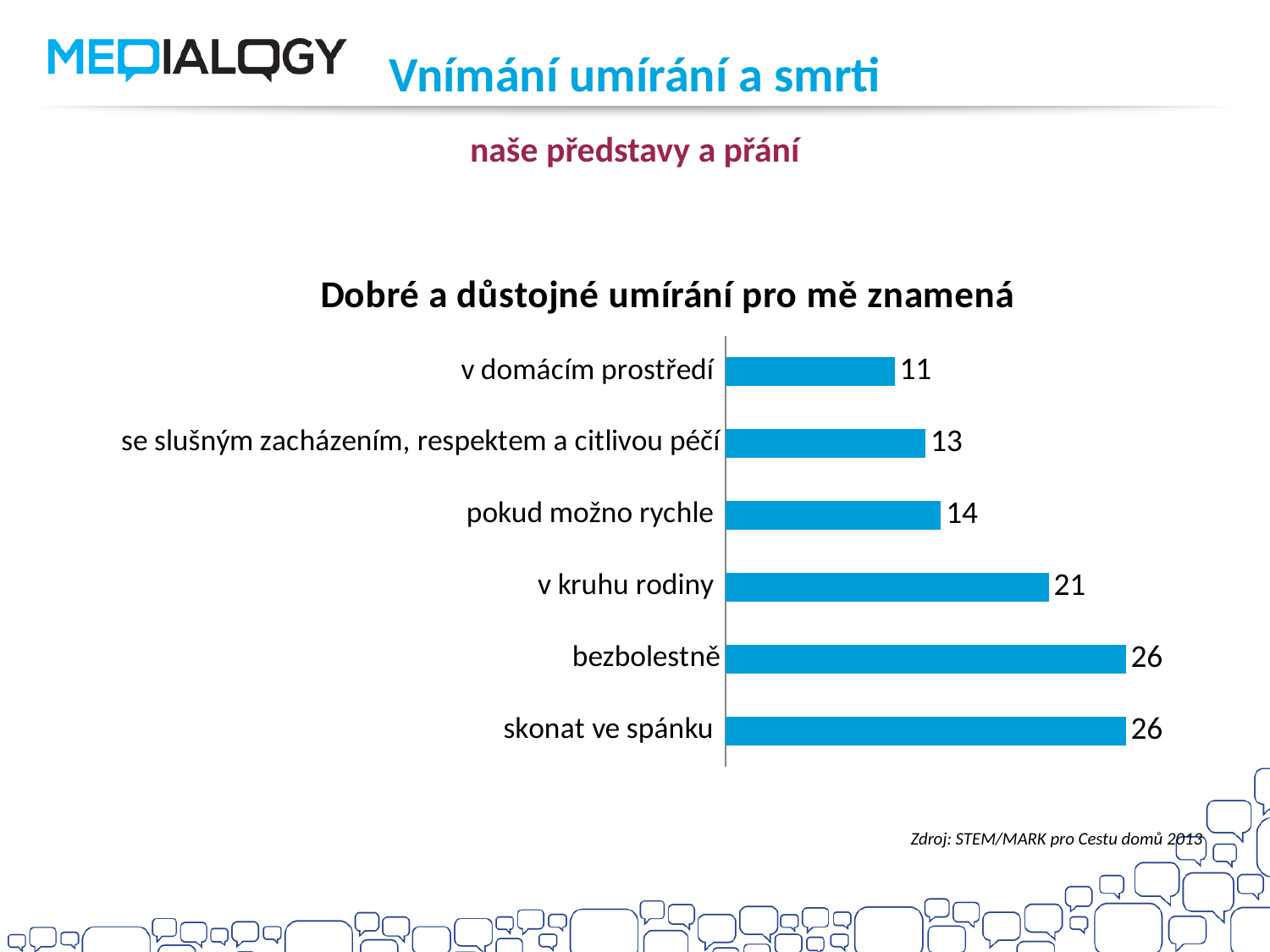
What is the value for "v kruhu rodiny"? 21 Which is larger, the value for "v kruhu rodiny" or the value for "pokud možno rychle"? v kruhu rodiny What is the value for "pokud možno rychle"? 14 Which category has the lowest value? v domácím prostředí What is the difference between the values for "pokud možno rychle" and "v domácím prostředí"? 3 What is the value for "v domácím prostředí"? 11 What colour are the bars in the chart? blue What is the difference between the values for "bezbolestně" and "v kruhu rodiny"? 5 What is the value for "se slušným zacházením, respektem a citlivou péčí"? 13 How many categories are shown in the chart? 6 What is the title of the chart? Dobré a důstojné umírání pro mě znamená What kind of chart is shown on the slide? bar chart